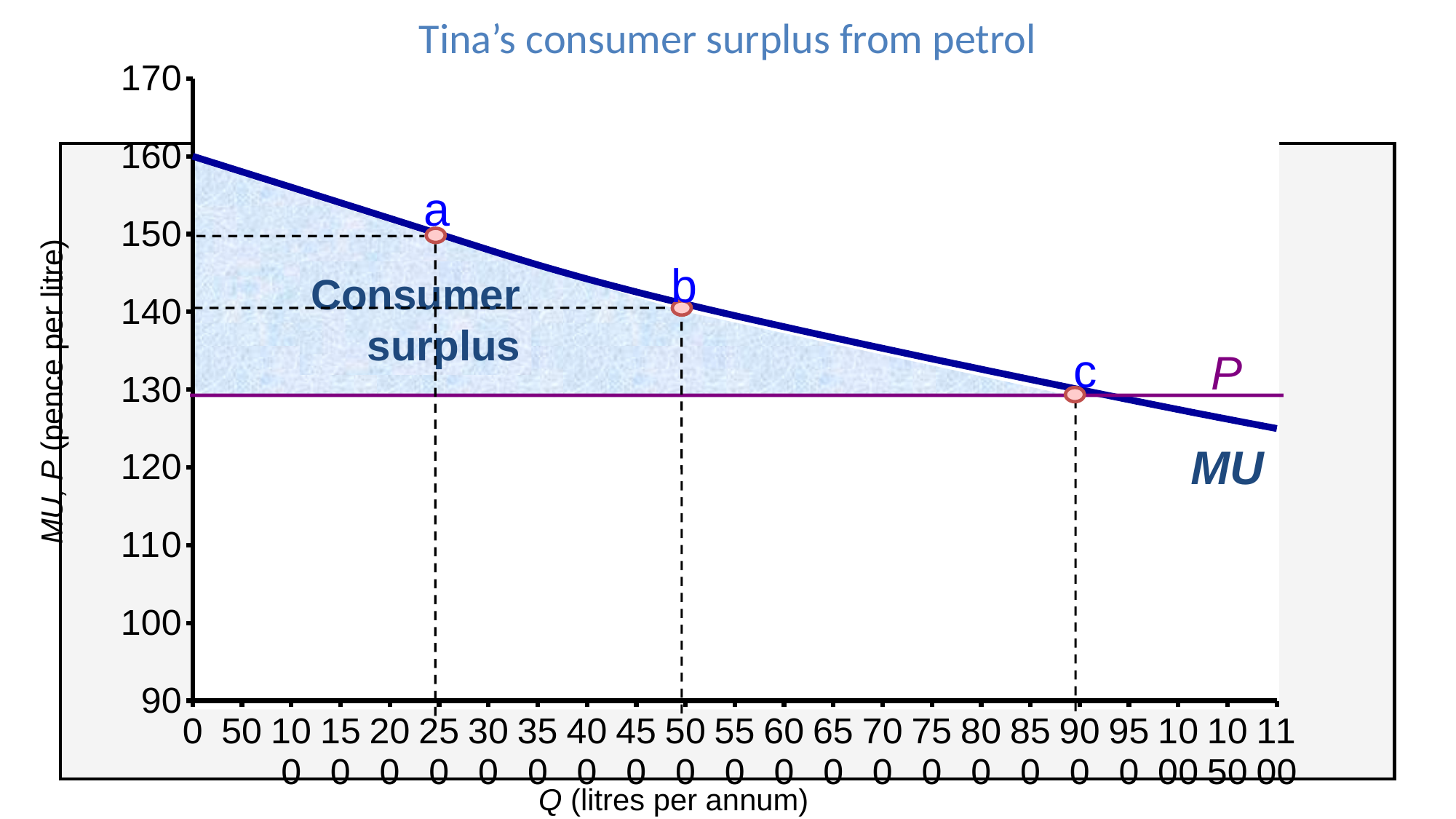
Does the MU curve rise or fall as Q increases along the x axis? fall How many labelled points (a, b, c) are marked on the MU curve? 3 At what quantity Q (litres per annum) is point b located? 500 At what quantity Q (litres per annum) is point a located? 250 At what quantity Q (litres per annum) is point c located? 900 What kind of chart is shown on the slide? line chart What is the title of the chart? Tina's consumer surplus from petrol What is the MU value (pence per litre) at point a? 150 Which point has the higher MU value, a or b? a Is the MU value at point c greater or less than 140? less